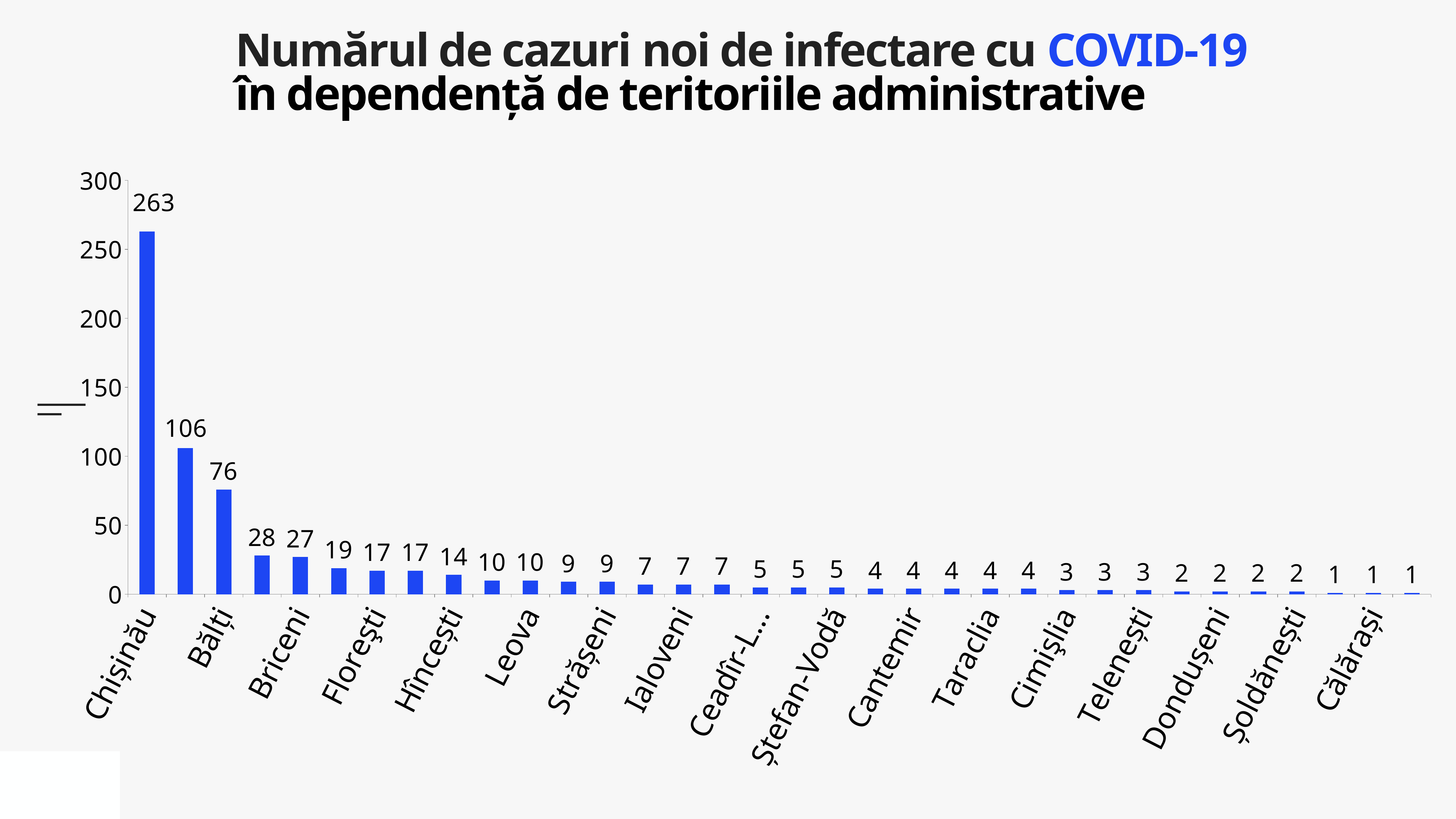
What colour are the bars? blue Is the value for Chișinău greater or less than 250? greater What is the lowest value shown on the chart? 1 Which category has the highest value? Chișinău What kind of chart is shown? bar chart What is the difference between the highest value (263) and the second-highest value (106)? 157 What is the highest value shown on the chart? 263 Which is larger, the value for Chișinău or the value for Bălți? Chișinău What is the second-highest value shown on the chart? 106 Do the values rise or fall from left to right along the x axis? fall What is the value for Chișinău? 263 Is the value for Călărași greater or less than 50? less